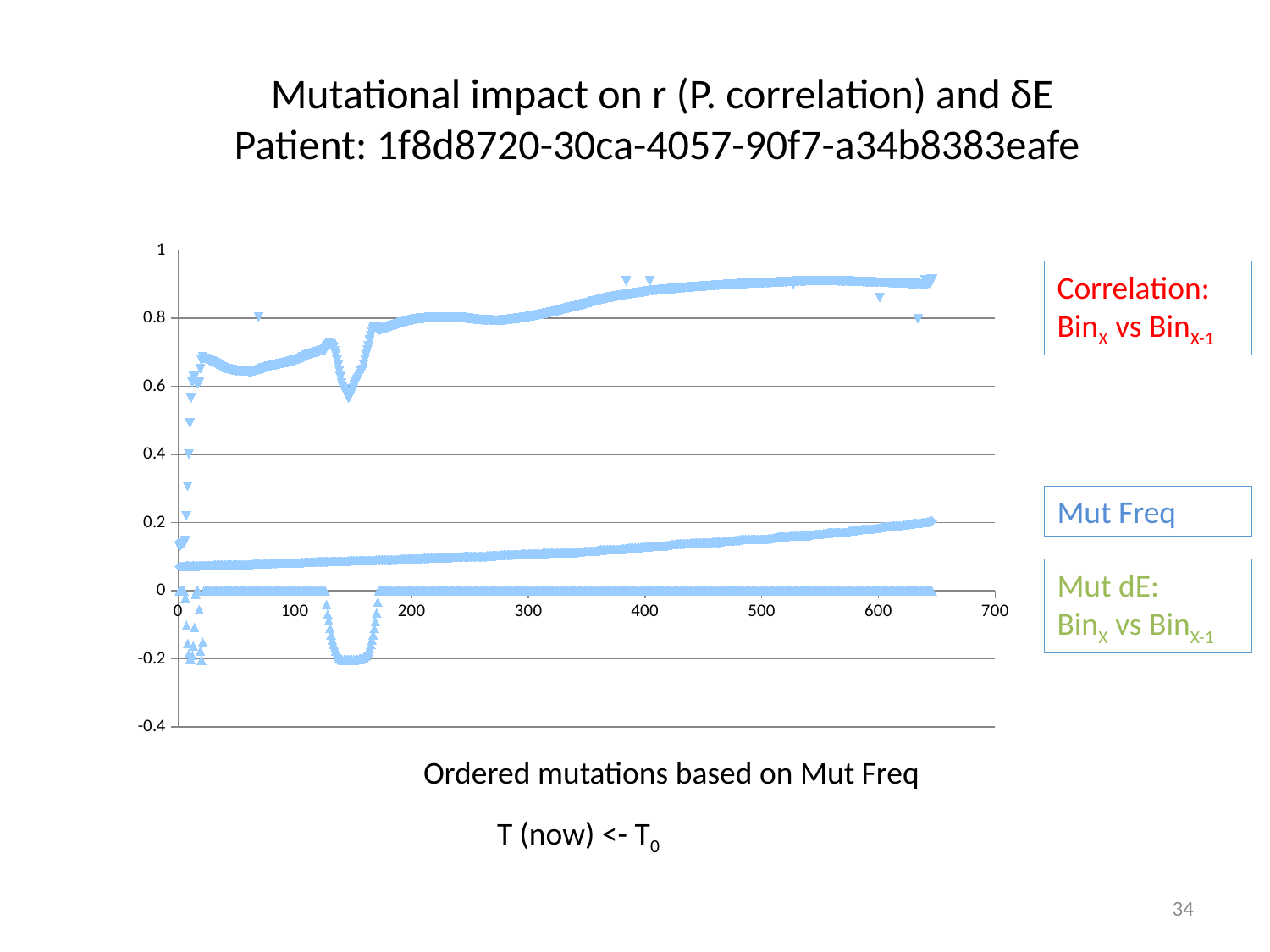
How many data series are labelled on the chart? 3 What kind of chart is shown on the slide? scatter chart What is the x-axis label of the chart? Ordered mutations based on Mut Freq Is the Correlation value at x = 600 greater or less than 0.8? greater Is the Mut dE value at x = 150 greater or less than 0? less Is the Mut Freq value at x = 300 greater or less than 0.2? less What is the highest tick value shown on the y axis? 1 Which series has the lowest values on the chart, Correlation, Mut Freq or Mut dE? Mut dE Does the Mut Freq series rise or fall as x increases from 0 to 650? rise At x = 400, which series has the larger value, Correlation or Mut Freq? Correlation